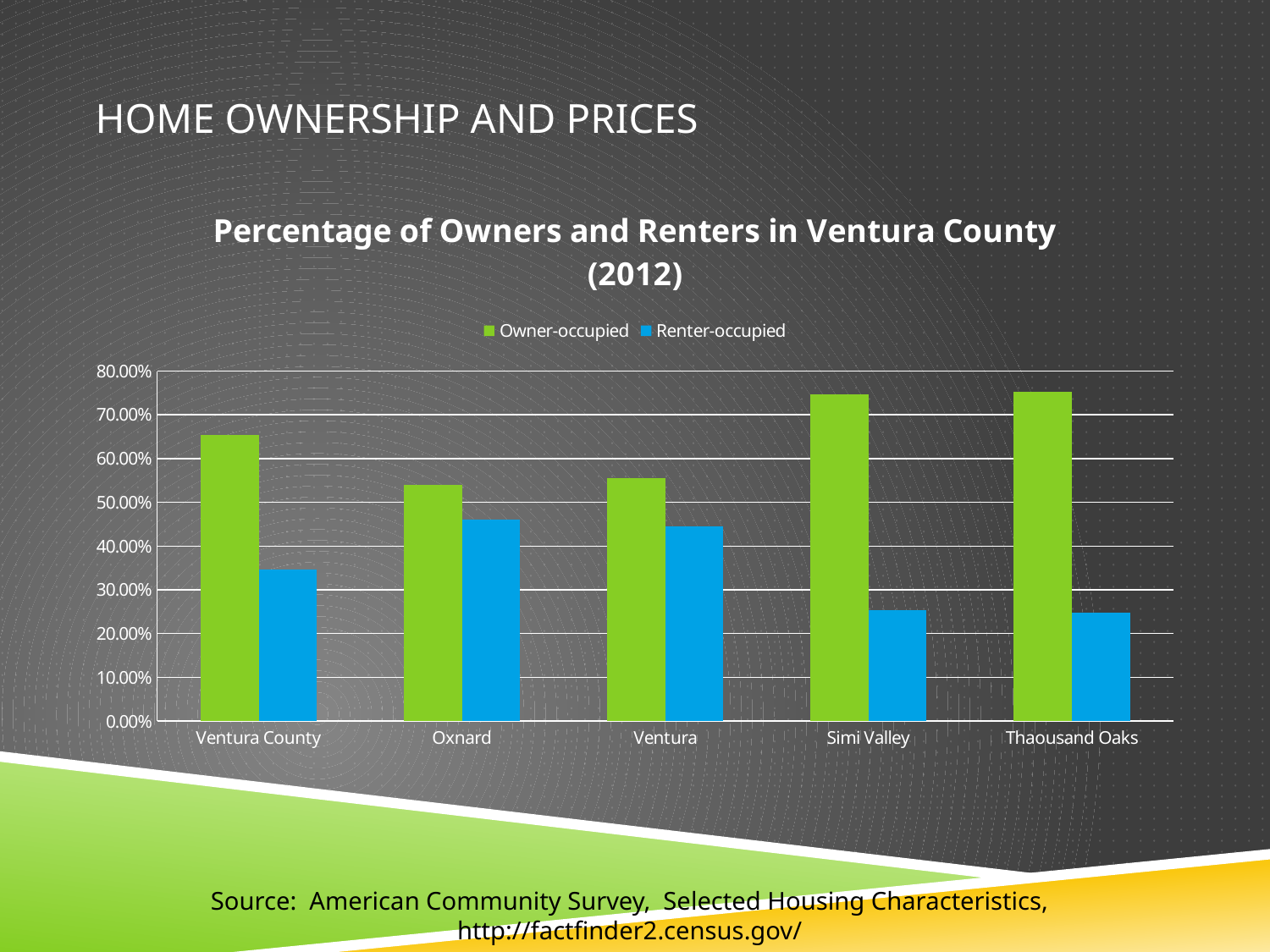
Is the Owner-occupied value for Thaousand Oaks greater or less than 70.00%? greater How many series does the legend list? 2 What is the title of the chart? Percentage of Owners and Renters in Ventura County (2012) Which is larger, the Owner-occupied value for Ventura County or the Owner-occupied value for Oxnard? Ventura County Is the Renter-occupied value for Simi Valley greater or less than 30.00%? less Which is larger, the Renter-occupied value for Ventura County or the Renter-occupied value for Simi Valley? Ventura County For Oxnard, which is larger, the Owner-occupied value or the Renter-occupied value? Owner-occupied Which series is shown in blue? Renter-occupied Is the Renter-occupied value for Oxnard greater or less than 40.00%? greater How many categories are shown on the x axis? 5 What kind of chart is shown on the slide? Bar chart